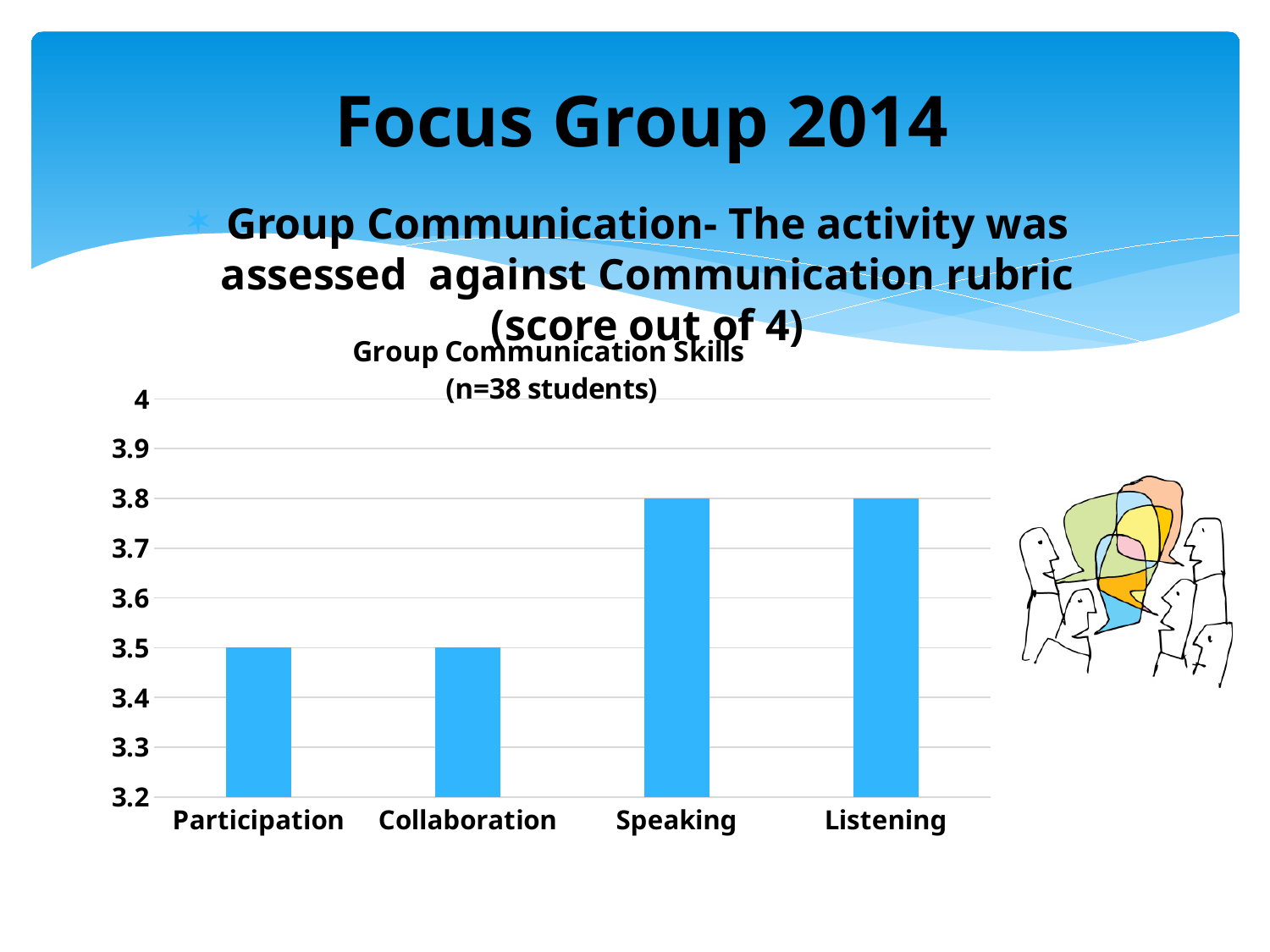
Which is larger, the value for Participation or the value for Listening? Listening What kind of chart is shown on the slide? Bar chart How many students does the chart title say were included (n)? 38 What is the value for Collaboration in the Group Communication Skills chart? 3.5 What is the value for Listening in the Group Communication Skills chart? 3.8 What is the value for Speaking in the Group Communication Skills chart? 3.8 Is the value for Participation greater or less than 3.6? less Is the value for Listening greater or less than 3.7? greater Which is larger, the value for Speaking or the value for Collaboration? Speaking How many categories are shown on the x axis of the chart? 4 What is the difference between the values for Speaking and Participation? 0.3 What is the value for Participation in the Group Communication Skills chart? 3.5